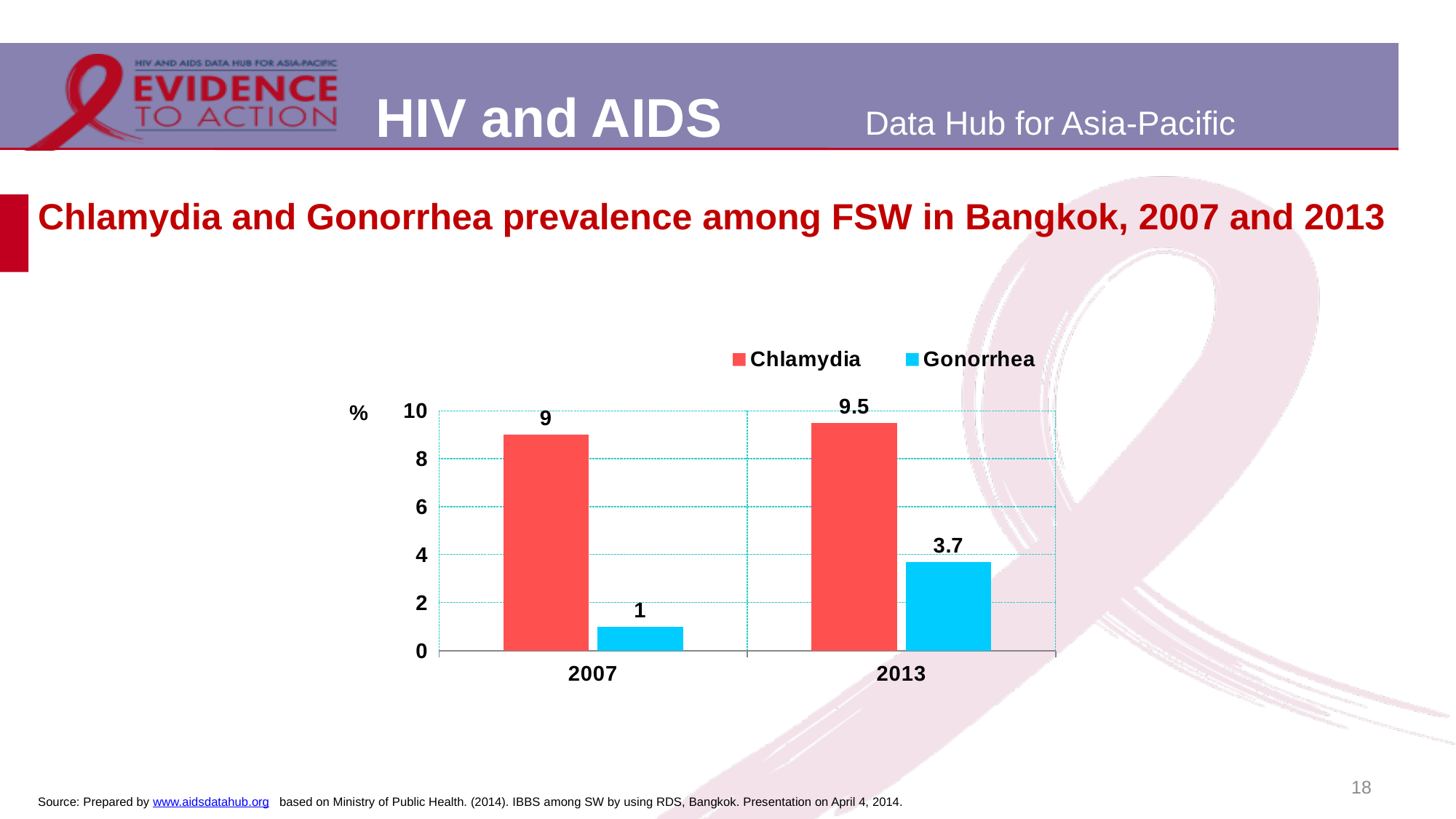
What was the Chlamydia prevalence among FSW in Bangkok in 2007? 9 What is the difference between Chlamydia and Gonorrhea prevalence in 2013? 5.8 What kind of chart is shown on the slide? Bar chart What was the Chlamydia prevalence in 2013? 9.5 By how much did Gonorrhea prevalence increase from 2007 to 2013? 2.7 What was the Gonorrhea prevalence among FSW in Bangkok in 2013? 3.7 Did Chlamydia prevalence rise or fall from 2007 to 2013? Rise Which series has the lowest value shown on the chart? Gonorrhea How many series does the legend list? 2 What was the Gonorrhea prevalence in 2007? 1 Which was higher in 2007, Chlamydia or Gonorrhea prevalence? Chlamydia In which year was Gonorrhea prevalence higher? 2013